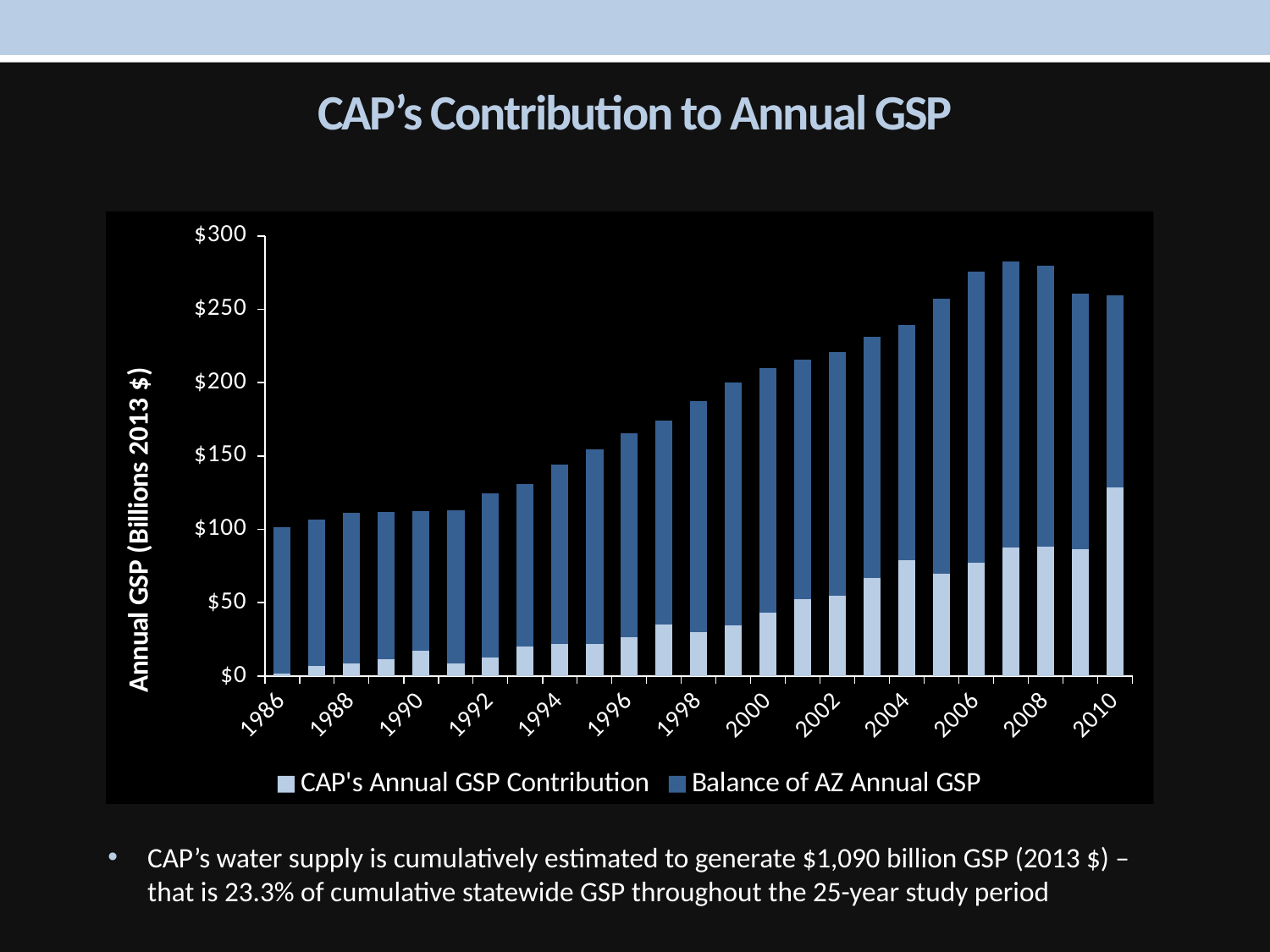
What kind of chart is shown on the slide? Stacked bar chart What is the label on the vertical axis of the chart? Annual GSP (Billions 2013 $) Is the total annual GSP for 1986 greater or less than $150? less How many years (bars) are plotted in the chart? 25 Is the total annual GSP for 2010 greater or less than $250? greater Which year has the smallest CAP's Annual GSP Contribution segment? 1986 Which year has the largest CAP's Annual GSP Contribution segment? 2010 Which year has a larger total annual GSP, 1996 or 2006? 2006 How many series does the legend list? 2 Is the CAP's Annual GSP Contribution for 2010 greater or less than $100? greater Does the total annual GSP generally rise or fall from 1986 to 2010? Rise Which year has the lowest total annual GSP? 1986